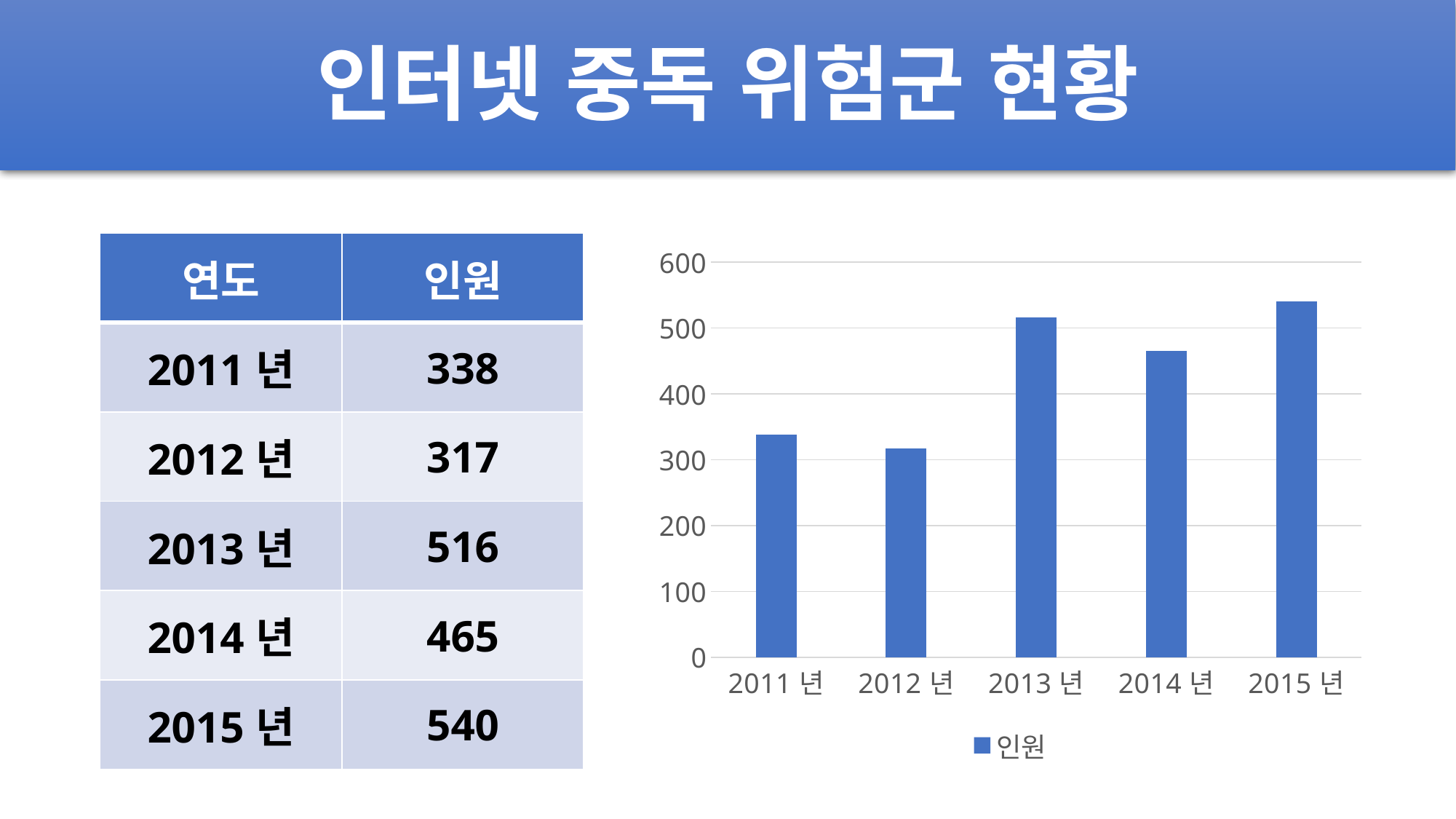
What is the difference between the values for 2015 년 and 2011 년? 202 How many years are plotted on the x axis of the chart? 5 What is the name of the series shown in the chart legend? 인원 What is the value for 2011 년? 338 Which is larger, the value for 2013 년 or the value for 2014 년? 2013 년 Which year has the lowest value in the chart? 2012 년 How many series does the chart legend list? 1 What is the value for 2013 년? 516 Which year has the highest value in the chart? 2015 년 Is the value for 2012 년 greater or less than 400? less Is the value for 2014 년 greater or less than 400? greater What kind of chart is shown on the slide? bar chart